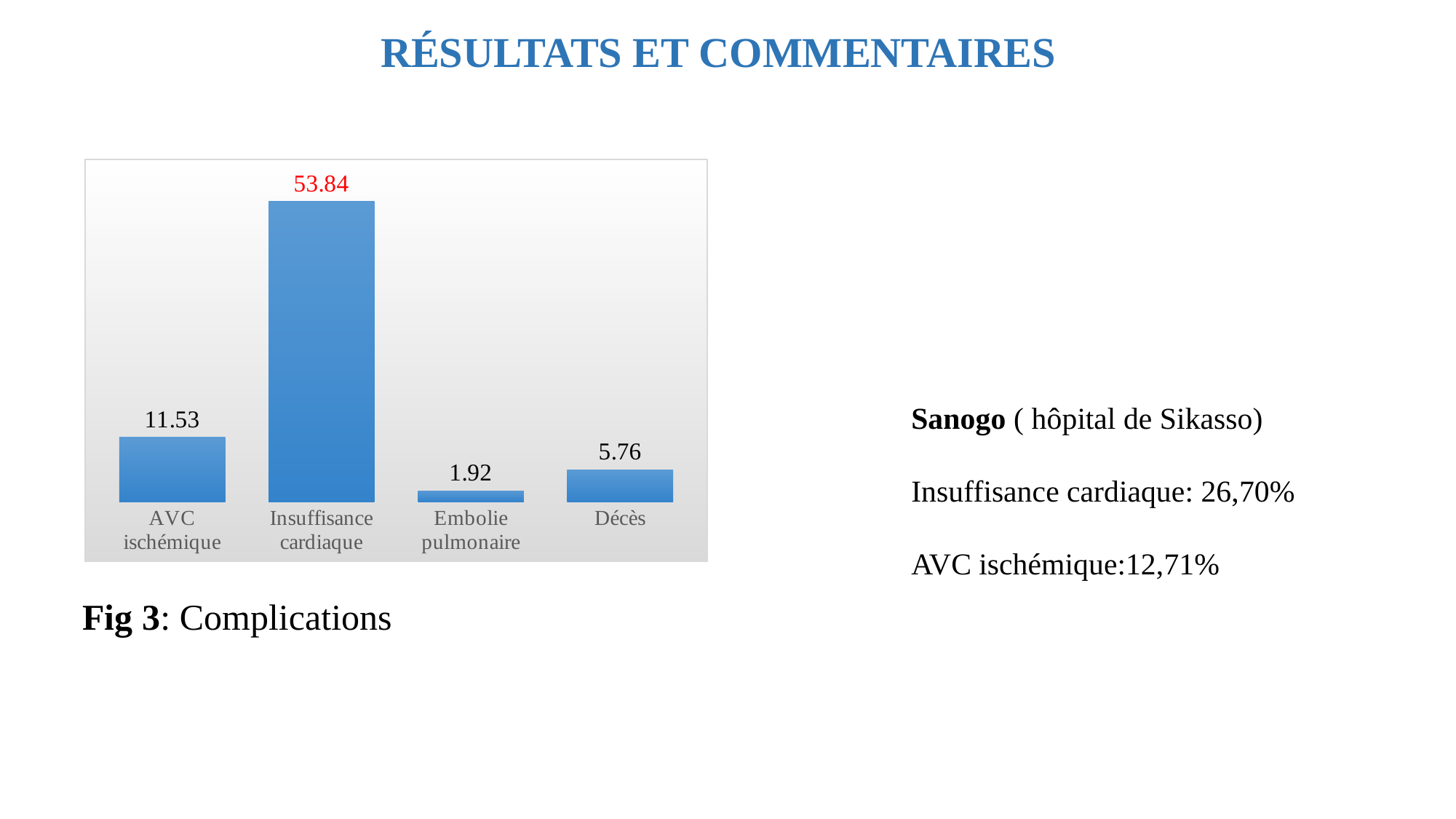
What kind of chart is shown in Fig 3? Bar chart What is the value for Embolie pulmonaire in the chart? 1.92 What is the value for Décès in the chart? 5.76 What is the caption of the chart on the slide? Fig 3: Complications What is the difference between the values for Insuffisance cardiaque and AVC ischémique? 42.31 What is the value for Insuffisance cardiaque in the Fig 3 Complications chart? 53.84 Which complication has the lowest value in the chart? Embolie pulmonaire What is the difference between the values for Décès and Embolie pulmonaire? 3.84 How many complication categories are shown in the chart? 4 Which is larger, the value for AVC ischémique or the value for Décès? AVC ischémique What is the value for AVC ischémique in the chart? 11.53 Which complication has the highest value in the chart? Insuffisance cardiaque